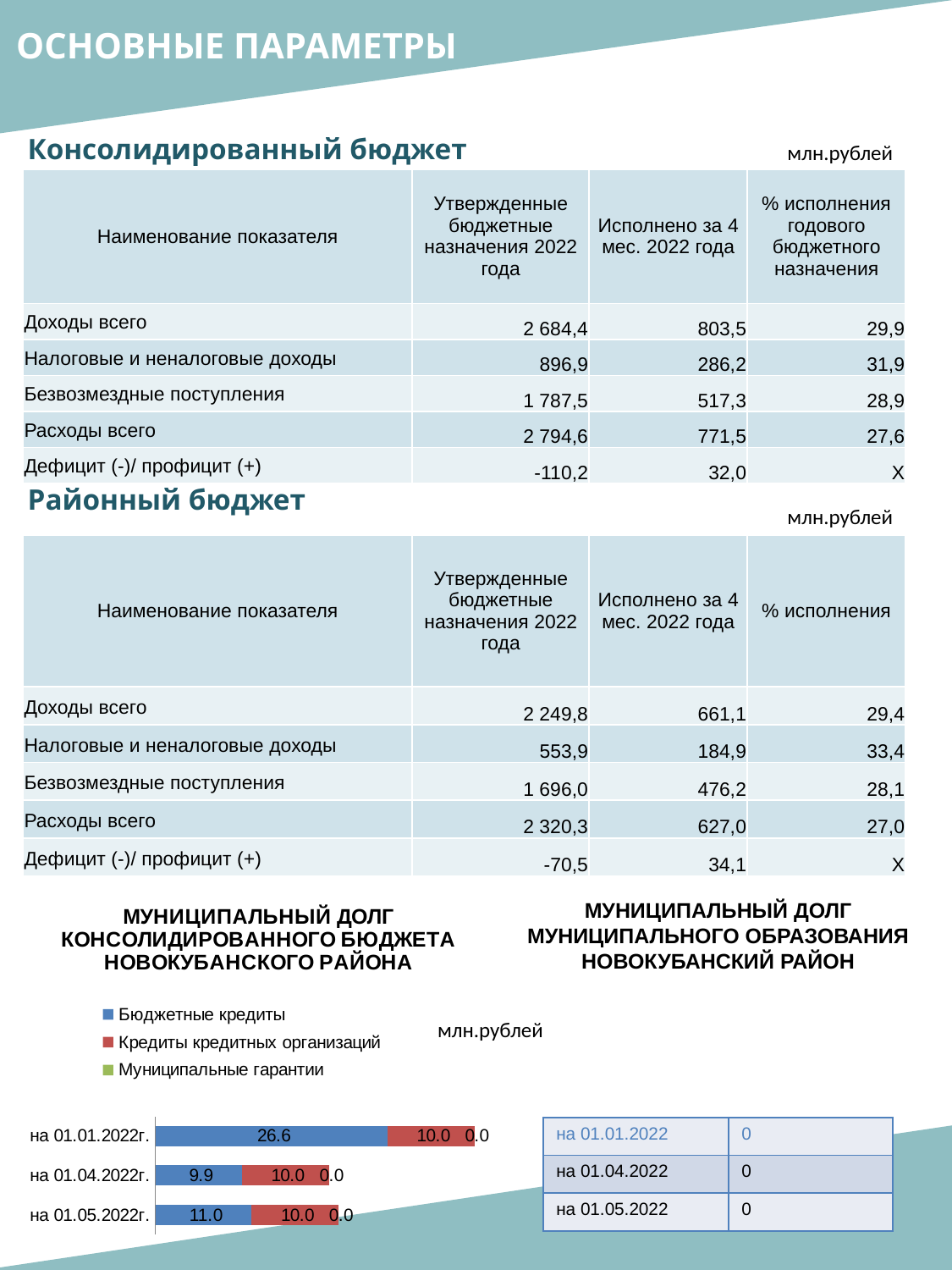
In the municipal debt chart, which date has the highest value for 'Бюджетные кредиты'? на 01.01.2022г. How many dates (categories) are shown on the municipal debt bar chart? 3 In the municipal debt chart, what is the value of 'Муниципальные гарантии' for 'на 01.04.2022г.'? 0.0 What type of chart is shown under the title 'МУНИЦИПАЛЬНЫЙ ДОЛГ КОНСОЛИДИРОВАННОГО БЮДЖЕТА НОВОКУБАНСКОГО РАЙОНА'? Bar chart In the municipal debt chart, what is the value of 'Бюджетные кредиты' for 'на 01.04.2022г.'? 9.9 In the municipal debt chart, which date has the lowest value for 'Бюджетные кредиты'? на 01.04.2022г. In the municipal debt chart, what is the total of the stacked bar for 'на 01.05.2022г.'? 21.0 How many series does the legend of the municipal debt chart list? 3 In the municipal debt chart, what is the value of 'Кредиты кредитных организаций' for 'на 01.05.2022г.'? 10.0 In the municipal debt chart, which colour represents 'Кредиты кредитных организаций'? Red In the municipal debt chart, what is the difference between 'Бюджетные кредиты' on 01.01.2022 and on 01.05.2022? 15.6 In the municipal debt chart, what is the value of 'Бюджетные кредиты' for 'на 01.01.2022г.'? 26.6